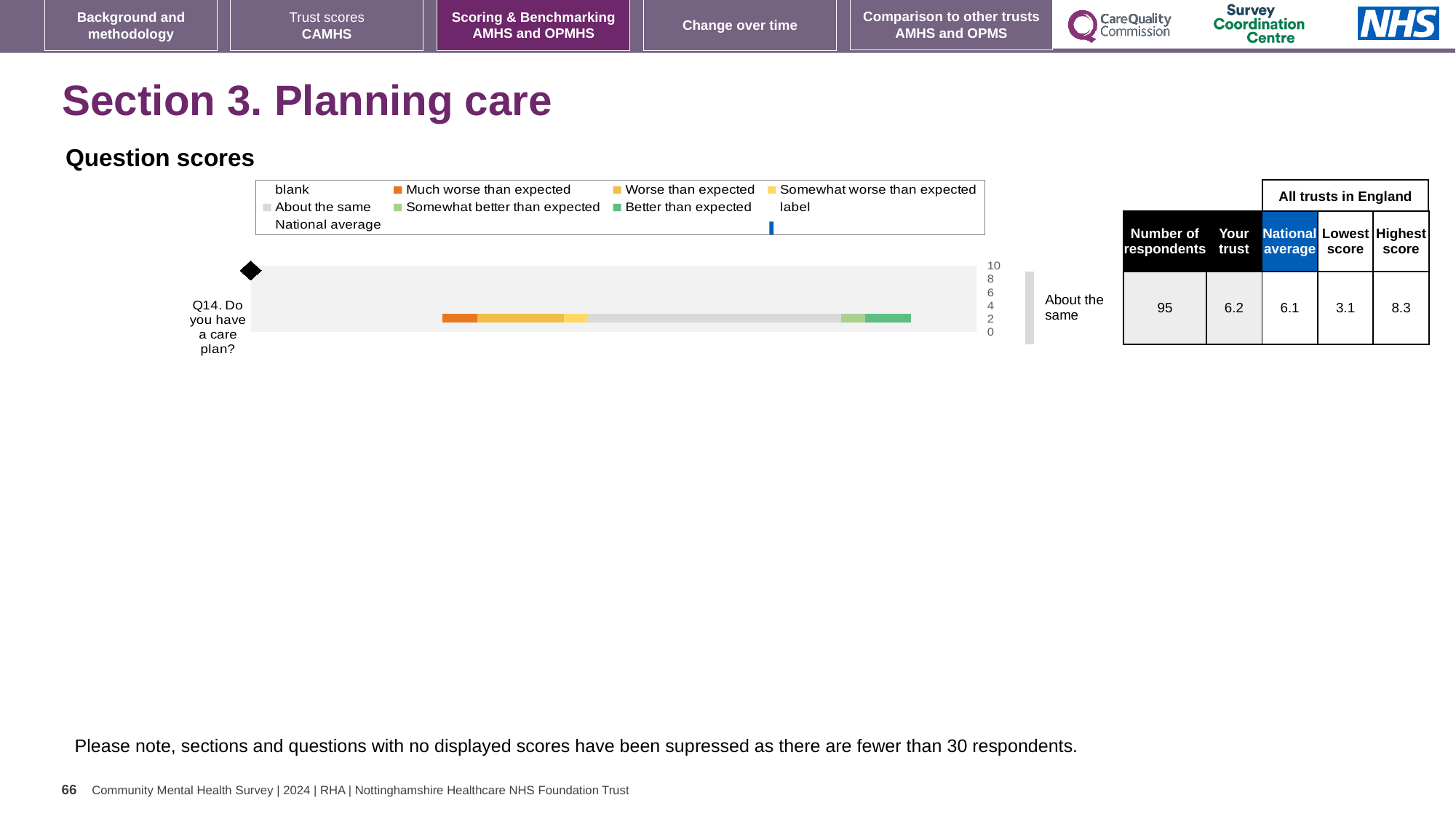
What is the text of question Q14 shown on the chart? Do you have a care plan? What is the 'Your trust' score for Q14? 6.2 What is the lowest score among all trusts in England for Q14? 3.1 What kind of chart is used to show the Q14 question score? Bar chart What benchmark category is shown next to the Q14 bar? About the same What is the highest score among all trusts in England for Q14? 8.3 What is the national average score for Q14? 6.1 How many respondents answered Q14? 95 Which is higher for Q14, the trust's score or the national average? Your trust How many questions are plotted in the Question scores chart? 1 What colour represents 'Much worse than expected' in the legend? Orange What is the difference between the highest and lowest scores for Q14? 5.2